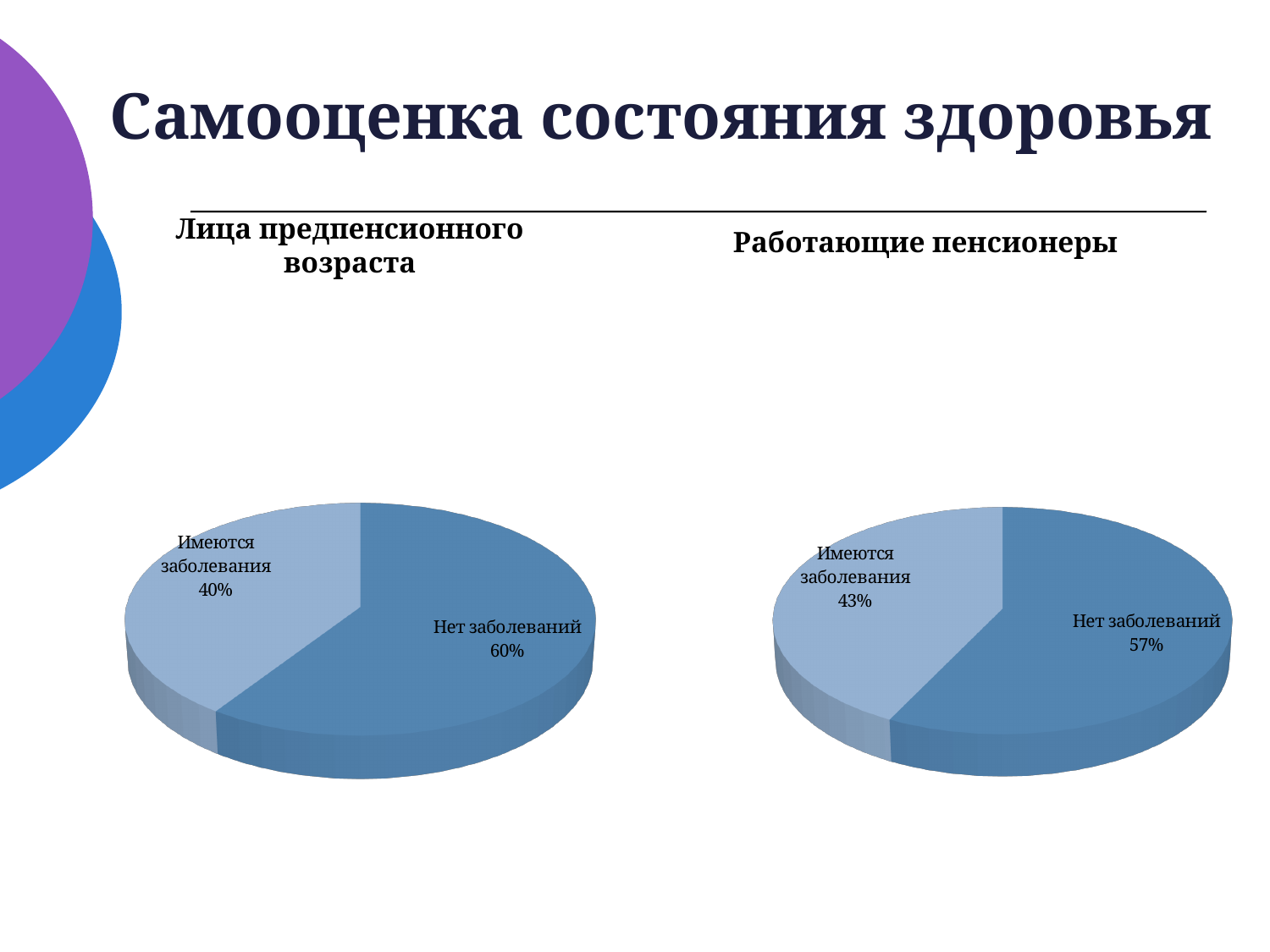
Which chart has the larger 'Имеются заболевания' share, 'Лица предпенсионного возраста' or 'Работающие пенсионеры'? Работающие пенсионеры In the 'Лица предпенсионного возраста' chart, what share is labelled 'Имеются заболевания'? 40% In the 'Лица предпенсионного возраста' chart, which slice is the largest? Нет заболеваний In the 'Работающие пенсионеры' chart, what share is labelled 'Имеются заболевания'? 43% In the 'Работающие пенсионеры' chart, which slice is the smallest? Имеются заболевания In the 'Работающие пенсионеры' chart, what share is labelled 'Нет заболеваний'? 57% In the 'Лица предпенсионного возраста' chart, what share is labelled 'Нет заболеваний'? 60% What kind of chart is used for 'Лица предпенсионного возраста'? Pie chart In the 'Лица предпенсионного возраста' chart, what is the difference between the 'Нет заболеваний' and 'Имеются заболевания' shares? 20% How many slices does the 'Работающие пенсионеры' chart have? 2 In the 'Работающие пенсионеры' chart, what is the difference between the 'Нет заболеваний' and 'Имеются заболевания' shares? 14% What is the title of the slide containing the two charts? Самооценка состояния здоровья